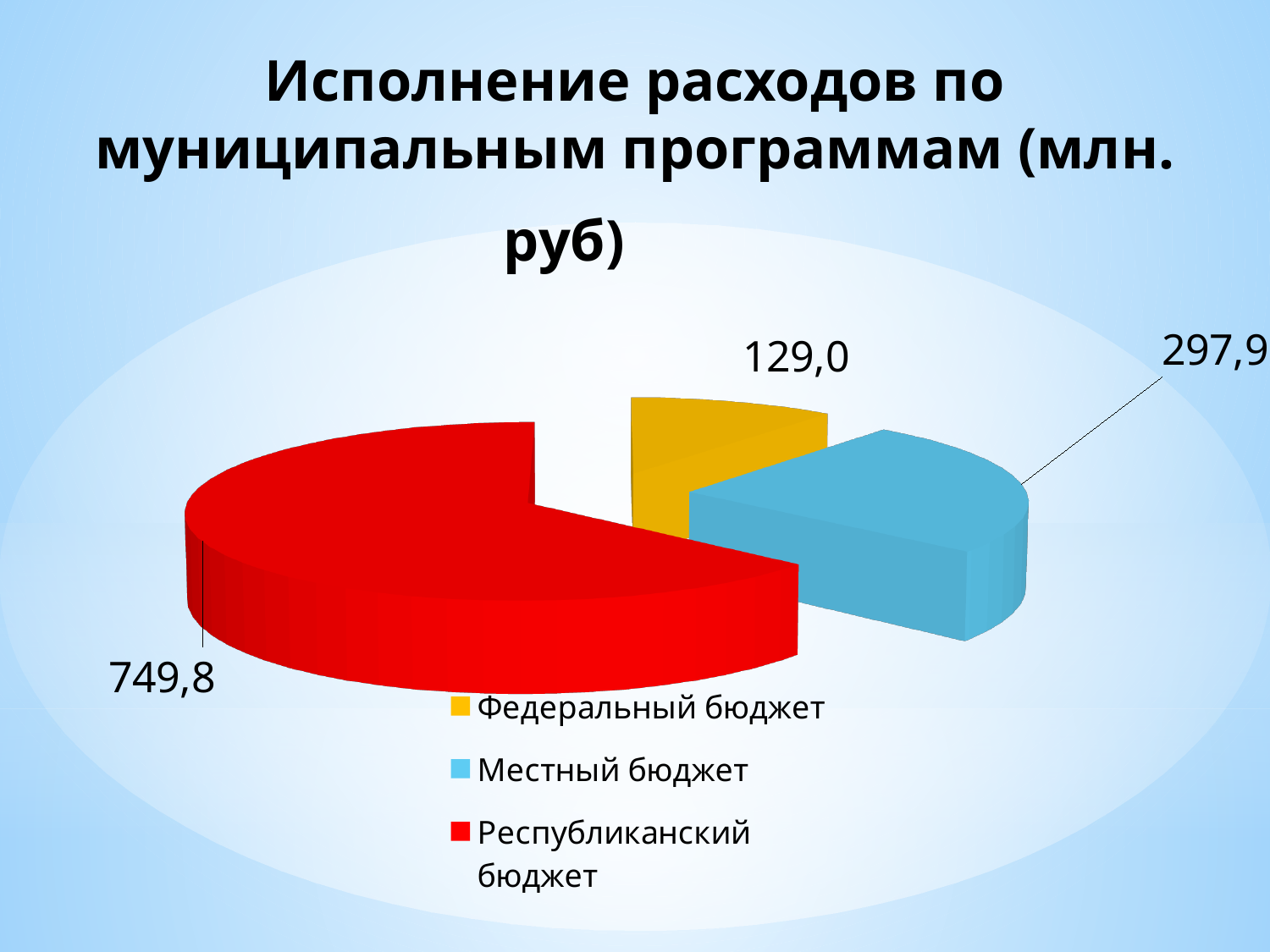
What kind of chart is shown on the slide? Pie chart What is the difference between the values for Местный бюджет and Федеральный бюджет? 168,9 How many slices does the pie chart have? 3 What colour is the slice for Местный бюджет? Blue Which budget has the largest value? Республиканский бюджет What is the difference between the values for Республиканский бюджет and Местный бюджет? 451,9 What is the value for Местный бюджет? 297,9 Which budget has the smallest value? Федеральный бюджет What is the value for Республиканский бюджет? 749,8 What is the value for Федеральный бюджет? 129,0 Which is larger, the value for Местный бюджет or Федеральный бюджет? Местный бюджет What is the total of all three slices? 1176,7